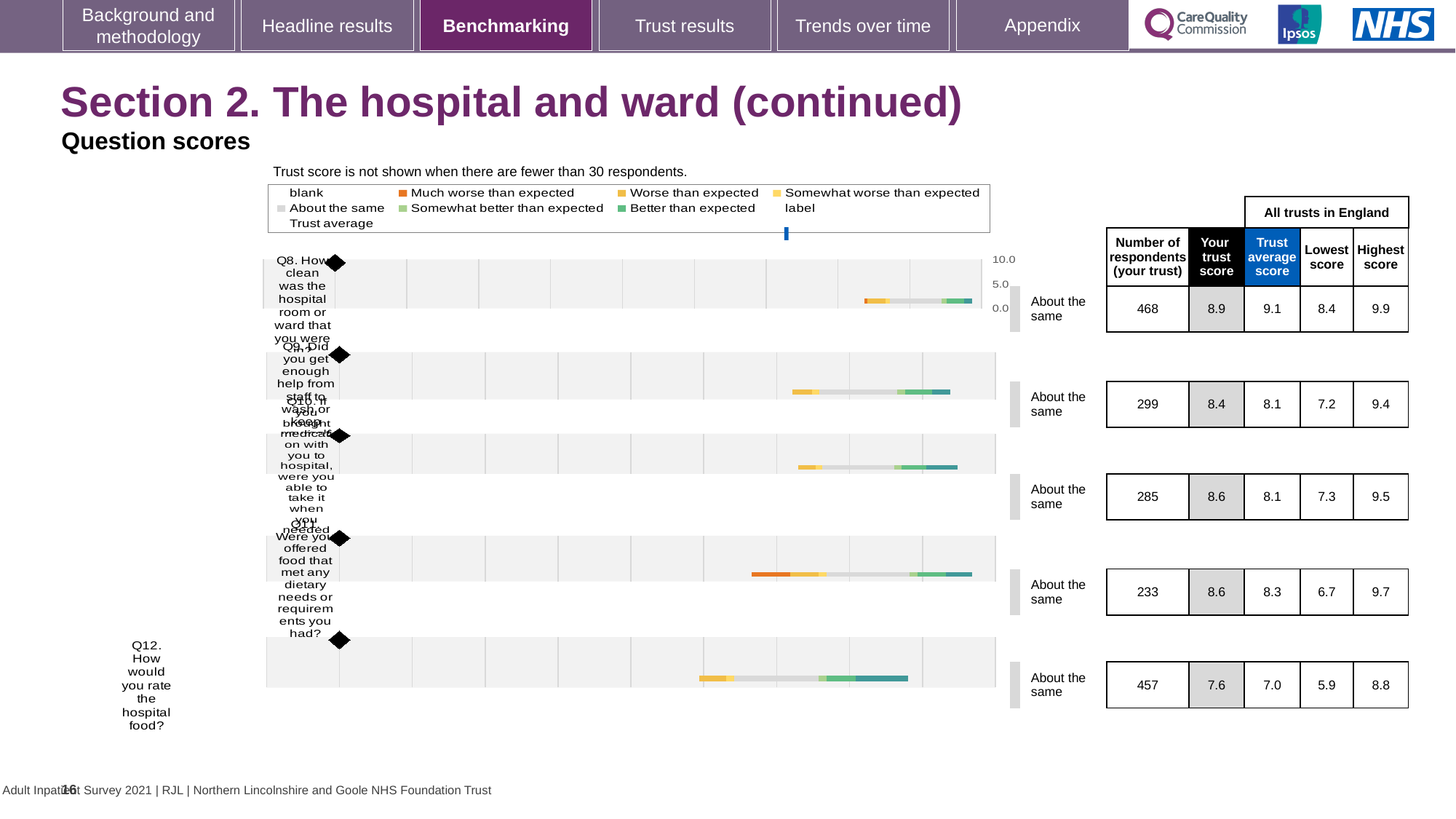
Which question has the lowest 'Your trust score'? Q12 What is the 'Highest score' across all trusts in England for Q11? 9.7 Which question has the highest 'Your trust score'? Q8 What is the difference between the 'Your trust score' and the 'Trust average score' for Q12? 0.6 What is the 'Trust average score' for Q9 (Did you get enough help from staff to wash or keep yourself clean)? 8.1 How many respondents (your trust) are shown for Q11 (Were you offered food that met any dietary needs)? 233 How many questions (categories) are plotted in the question scores chart? 5 For Q9, which is larger: the 'Your trust score' or the 'Trust average score'? Your trust score What benchmark category is shown next to every question in the chart? About the same What kind of chart is used to show the question scores on this slide? bar chart What is the 'Your trust score' for Q8 (How clean was the hospital room or ward)? 8.9 What is the 'Your trust score' for Q12 (How would you rate the hospital food)? 7.6